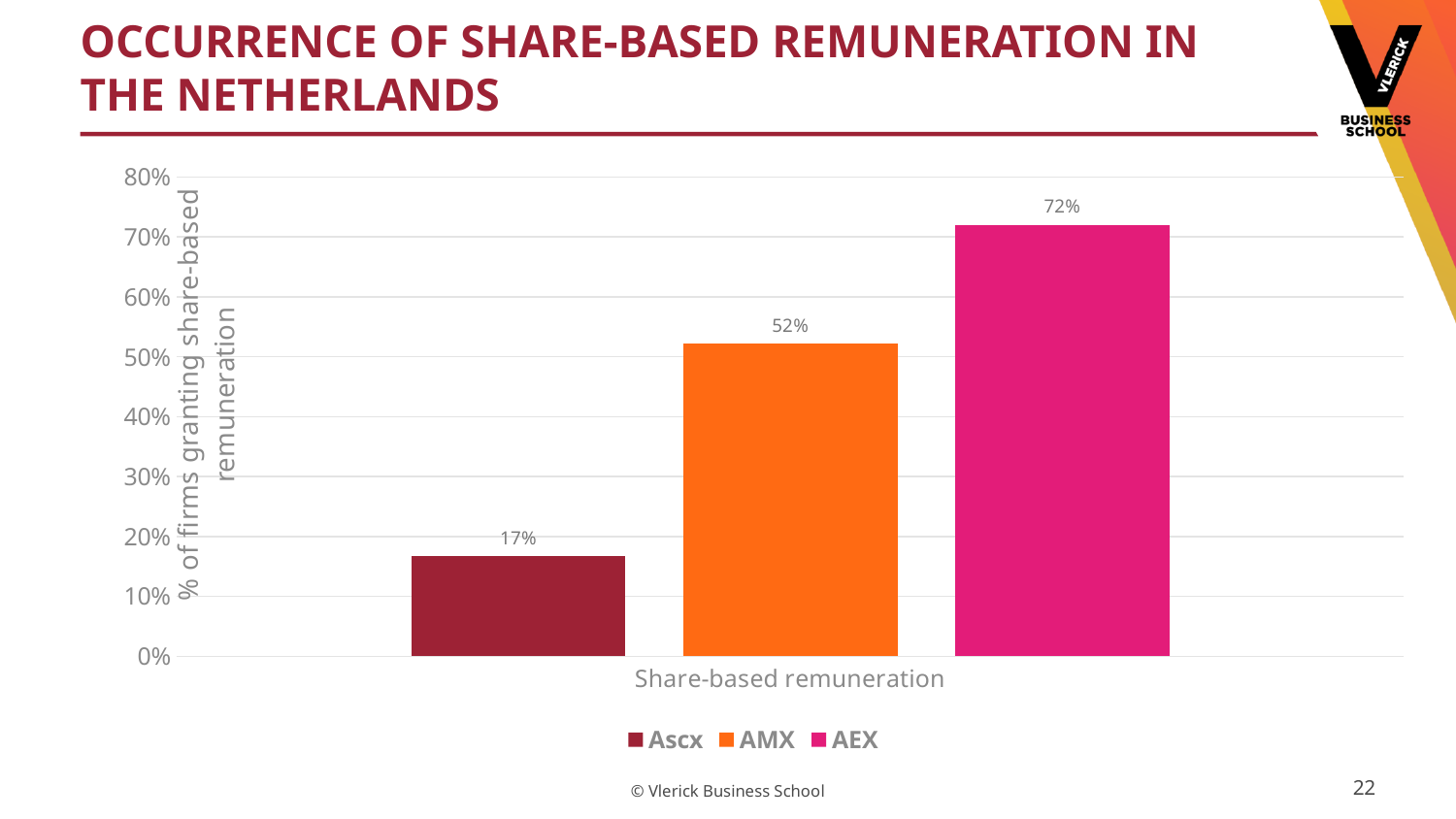
What percentage of Ascx firms grant share-based remuneration? 17% Which series has the lowest share of firms granting share-based remuneration? Ascx Is the value for AMX greater or less than 50%? greater What is the value shown for AMX? 52% Which is larger, the value for AMX or the value for Ascx? AMX What is the difference between the AEX and AMX values? 20% How many series does the legend list? 3 What kind of chart is shown on the slide? Bar chart Which series has the highest share of firms granting share-based remuneration? AEX What is the value shown for AEX? 72% What is the label on the vertical axis of the chart? % of firms granting share-based remuneration What is the difference between the AEX and Ascx values? 55%